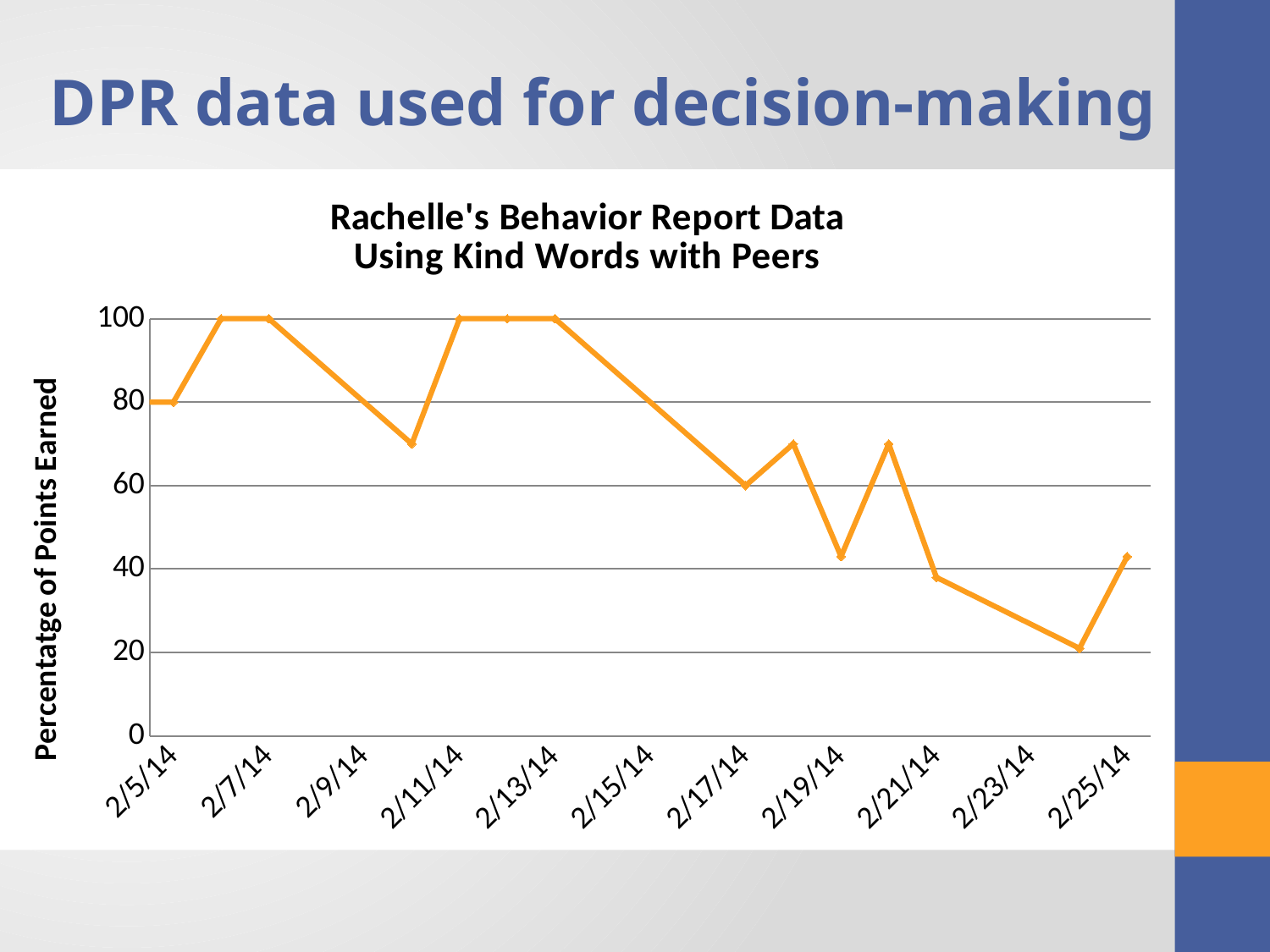
What is the label on the vertical axis? Percentatge of Points Earned What percentage of points was earned on 2/5/14? 80 Which date has the larger value, 2/11/14 or 2/17/14? 2/11/14 What percentage of points was earned on 2/17/14? 60 What is the highest percentage value reached on the chart? 100 What percentage of points was earned on 2/13/14? 100 What kind of chart is shown on the slide? line chart What is the title of the chart? Rachelle's Behavior Report Data Using Kind Words with Peers What is the difference between the values on 2/11/14 and 2/17/14? 40 Overall, do the values rise or fall from 2/5/14 to 2/25/14? fall Is the value for 2/25/14 greater or less than 60? less What percentage of points was earned on 2/11/14? 100